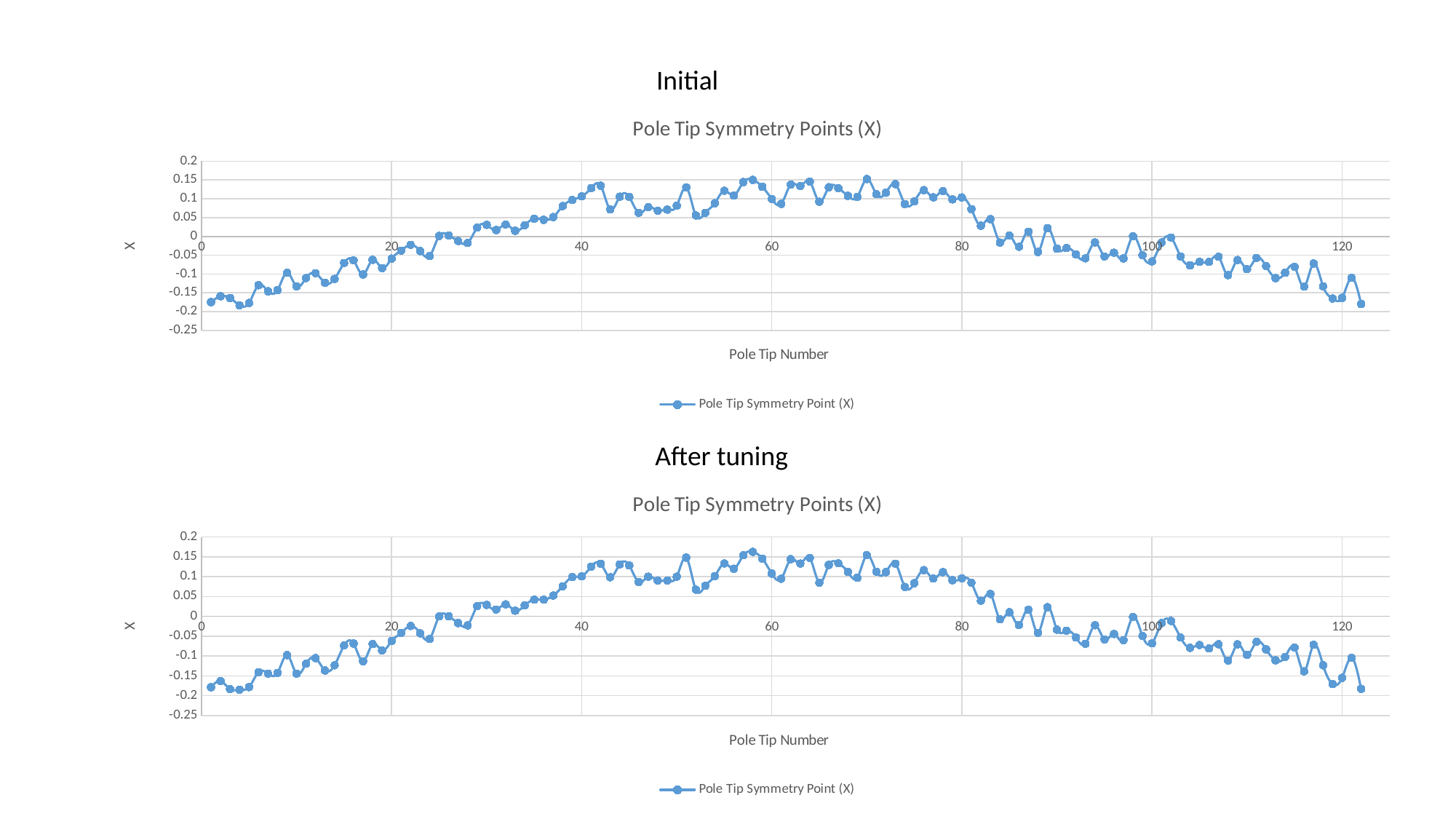
How many series does the legend of the 'Initial' chart list? 1 What kind of chart is the 'Initial' chart? line chart In the 'After tuning' chart, is the value for pole tip number 1 greater or less than -0.1? less In the 'After tuning' chart, is the value for pole tip number 40 greater or less than 0.05? greater In the 'After tuning' chart, do the values generally rise or fall between pole tip number 80 and pole tip number 120? fall In the 'Initial' chart, is the value for pole tip number 120 greater or less than -0.05? less What is the x-axis title of the 'Initial' chart? Pole Tip Number What kind of chart is the 'After tuning' chart? line chart In the 'Initial' chart, do the values generally rise or fall between pole tip number 1 and pole tip number 40? rise How many series does the legend of the 'After tuning' chart list? 1 What is the legend entry shown on the 'After tuning' chart? Pole Tip Symmetry Point (X)